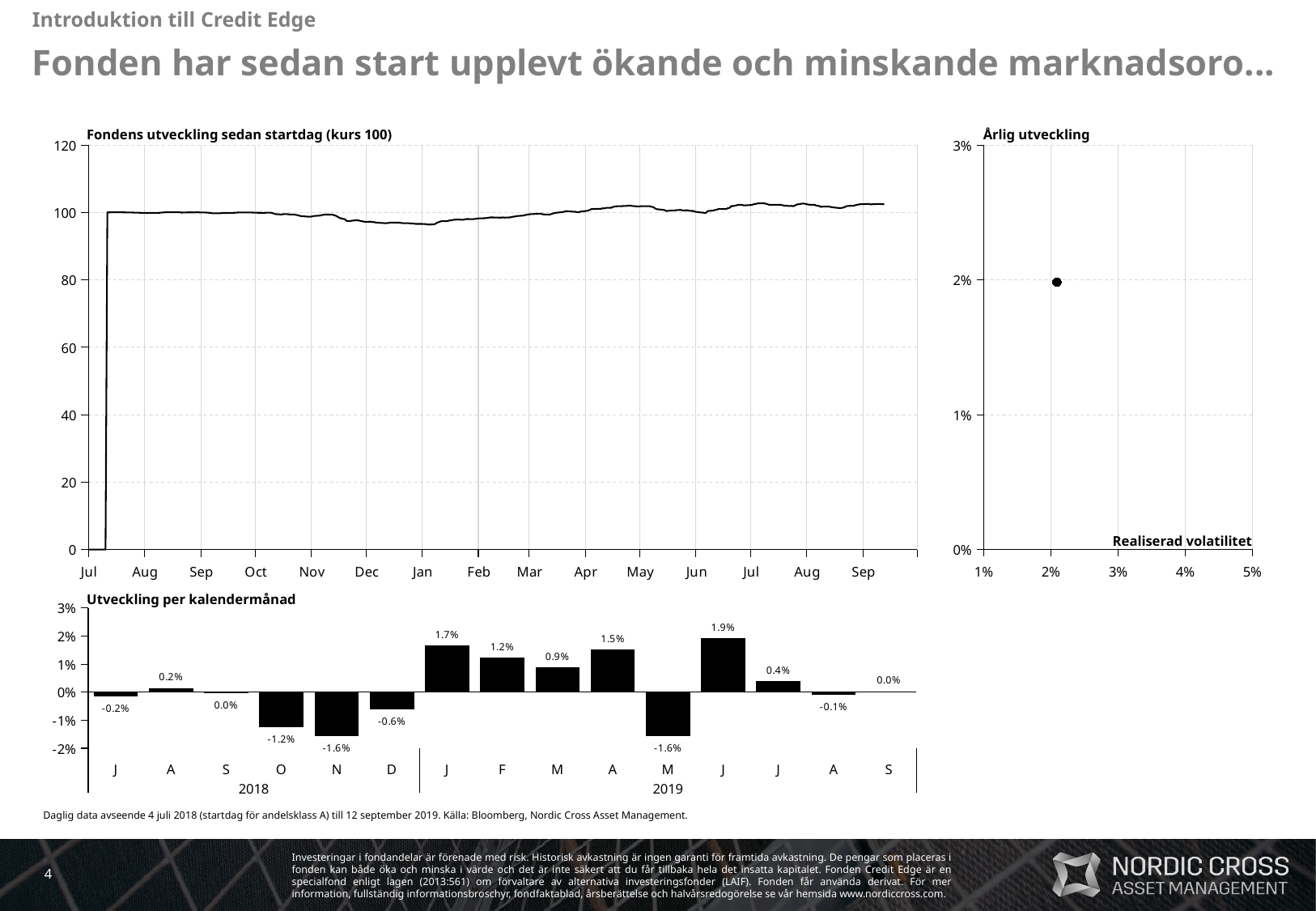
In the 'Utveckling per kalendermånad' chart, what is the value for January 2019 (J)? 1.7% What kind of chart is 'Fondens utveckling sedan startdag (kurs 100)'? Line chart In the 'Utveckling per kalendermånad' chart, what is the value for June 2019 (J)? 1.9% In the 'Utveckling per kalendermånad' chart, what is the difference between the values for January 2019 (1.7%) and February 2019 (1.2%)? 0.5% In the 'Utveckling per kalendermånad' chart, what is the value for November 2018 (N)? -1.6% In the 'Utveckling per kalendermånad' chart, which month has the highest value? June 2019 (J), 1.9% What is the x-axis label of the 'Årlig utveckling' chart? Realiserad volatilitet How many monthly bars are shown in the 'Utveckling per kalendermånad' chart? 15 In the 'Utveckling per kalendermånad' chart, which is larger: the value for April 2019 (A) or the value for March 2019 (M)? April 2019 (1.5%) In the 'Fondens utveckling sedan startdag (kurs 100)' chart, is the value in Sep 2019 greater or less than 80? greater In the 'Årlig utveckling' chart, is the plotted annual return greater or less than 1%? greater What kind of chart is 'Utveckling per kalendermånad'? Bar chart